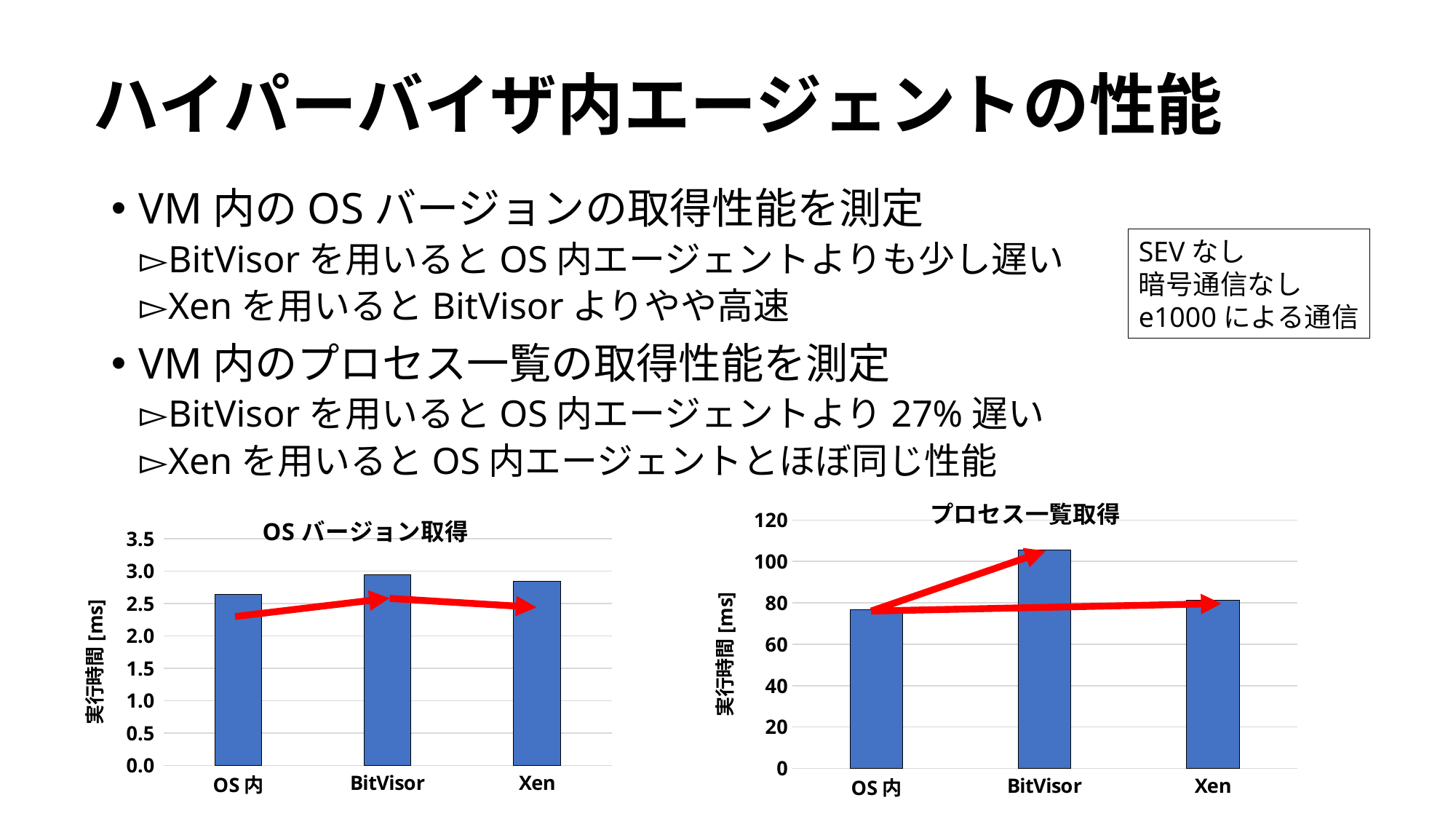
How many categories are shown on the x axis of the "プロセス一覧取得" chart on the right? 3 In the "プロセス一覧取得" chart on the right, is the value for BitVisor greater or less than 100? greater In the "OS バージョン取得" chart on the left, which category has the lowest value? OS 内 In the "OS バージョン取得" chart on the left, is the value for OS 内 greater or less than 3.0? less In the "プロセス一覧取得" chart on the right, which is larger, the value for BitVisor or the value for OS 内? BitVisor In the "OS バージョン取得" chart on the left, is the value for BitVisor greater or less than 2.5? greater What is the y-axis label of the "プロセス一覧取得" chart on the right? 実行時間 [ms] What kind of chart is the "OS バージョン取得" chart on the left? bar chart In the "OS バージョン取得" chart on the left, which is larger, the value for BitVisor or the value for OS 内? BitVisor In the "プロセス一覧取得" chart on the right, which category has the highest value? BitVisor